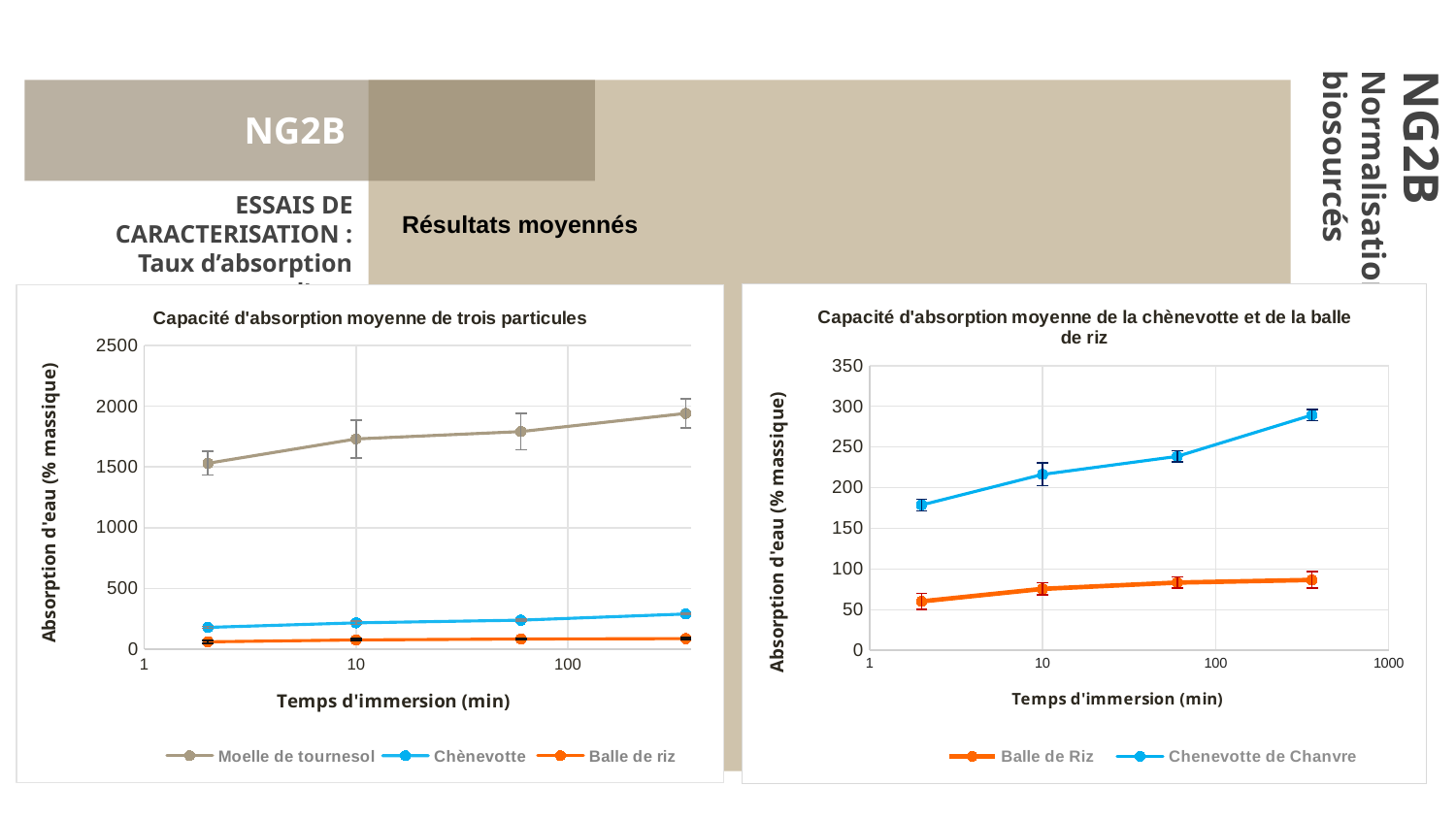
In the right chart, 'Capacité d'absorption moyenne de la chènevotte et de la balle de riz', how many data points are plotted for the Chenevotte de Chanvre series? 4 In the left chart, 'Capacité d'absorption moyenne de trois particules', is the value for Moelle de tournesol at 10 min greater or less than 1500? greater How many series does the legend of the left chart, 'Capacité d'absorption moyenne de trois particules', list? 3 What is the x-axis label of the left chart, 'Capacité d'absorption moyenne de trois particules'? Temps d'immersion (min) In the right chart, 'Capacité d'absorption moyenne de la chènevotte et de la balle de riz', is the last (rightmost) value for Chenevotte de Chanvre greater or less than 250? greater In the left chart, 'Capacité d'absorption moyenne de trois particules', which series has the highest absorption values? Moelle de tournesol In the right chart, 'Capacité d'absorption moyenne de la chènevotte et de la balle de riz', do the values for Balle de Riz rise or fall as immersion time increases? rise In the right chart, 'Capacité d'absorption moyenne de la chènevotte et de la balle de riz', is the first (leftmost) value for Chenevotte de Chanvre greater or less than 200? less In the left chart, 'Capacité d'absorption moyenne de trois particules', which series has the lowest absorption values? Balle de riz In the right chart, 'Capacité d'absorption moyenne de la chènevotte et de la balle de riz', which series is larger at 100 min: Balle de Riz or Chenevotte de Chanvre? Chenevotte de Chanvre How many series does the legend of the right chart, 'Capacité d'absorption moyenne de la chènevotte et de la balle de riz', list? 2 What kind of chart is the left chart, 'Capacité d'absorption moyenne de trois particules'? line chart